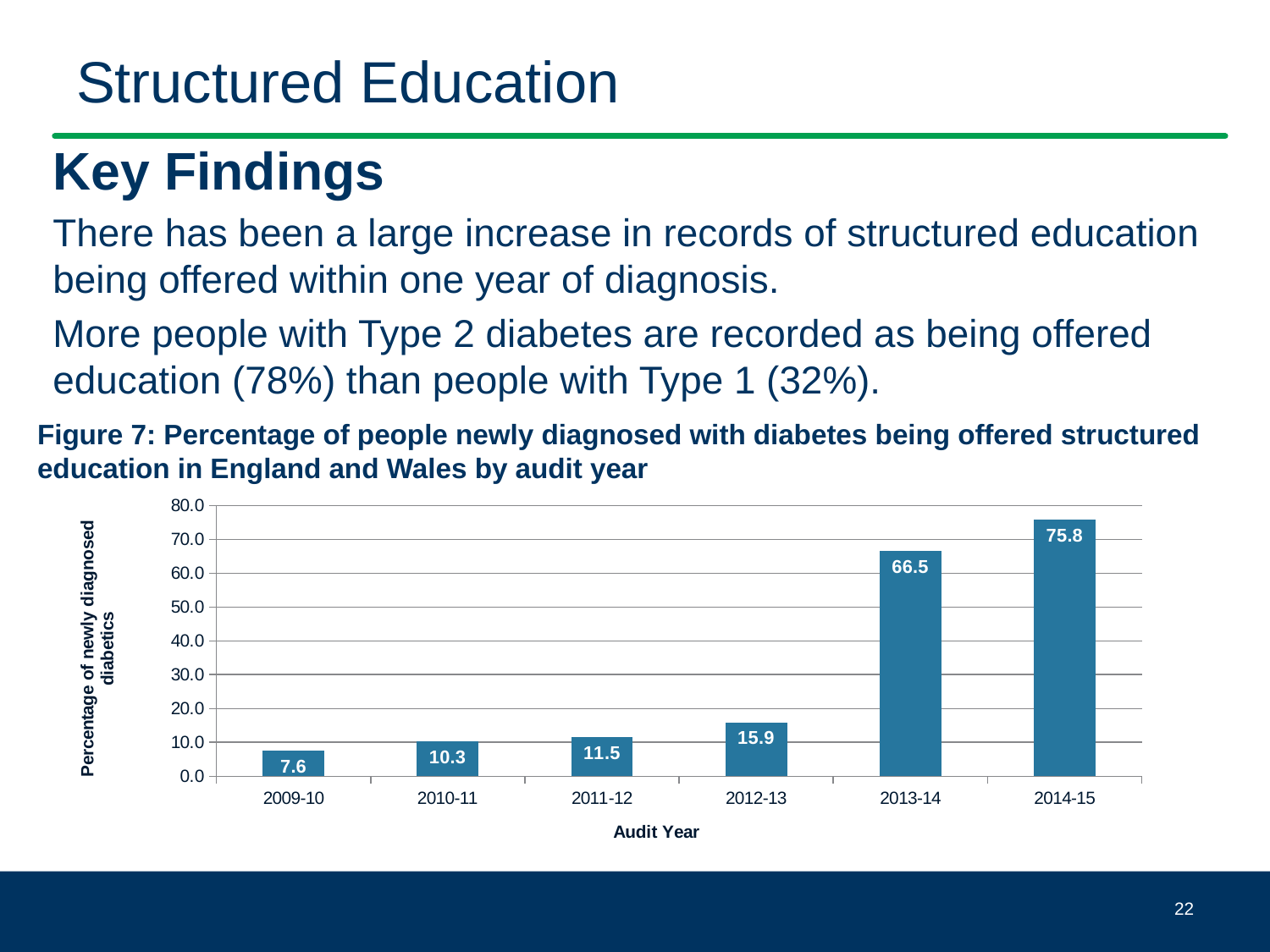
Is the value for 2013-14 greater or less than 60.0? greater Do the values rise or fall from 2009-10 to 2014-15? rise What is the value for 2011-12? 11.5 What is the difference between the values for 2012-13 and 2011-12? 4.4 Which is larger, the value for 2010-11 or the value for 2012-13? 2012-13 How many audit years are shown on the x axis? 6 What is the difference between the values for 2014-15 and 2013-14? 9.3 What kind of chart is shown? bar chart What is the value for 2013-14? 66.5 Which audit year has the lowest value? 2009-10 What is the value for 2009-10? 7.6 Which audit year has the highest value? 2014-15